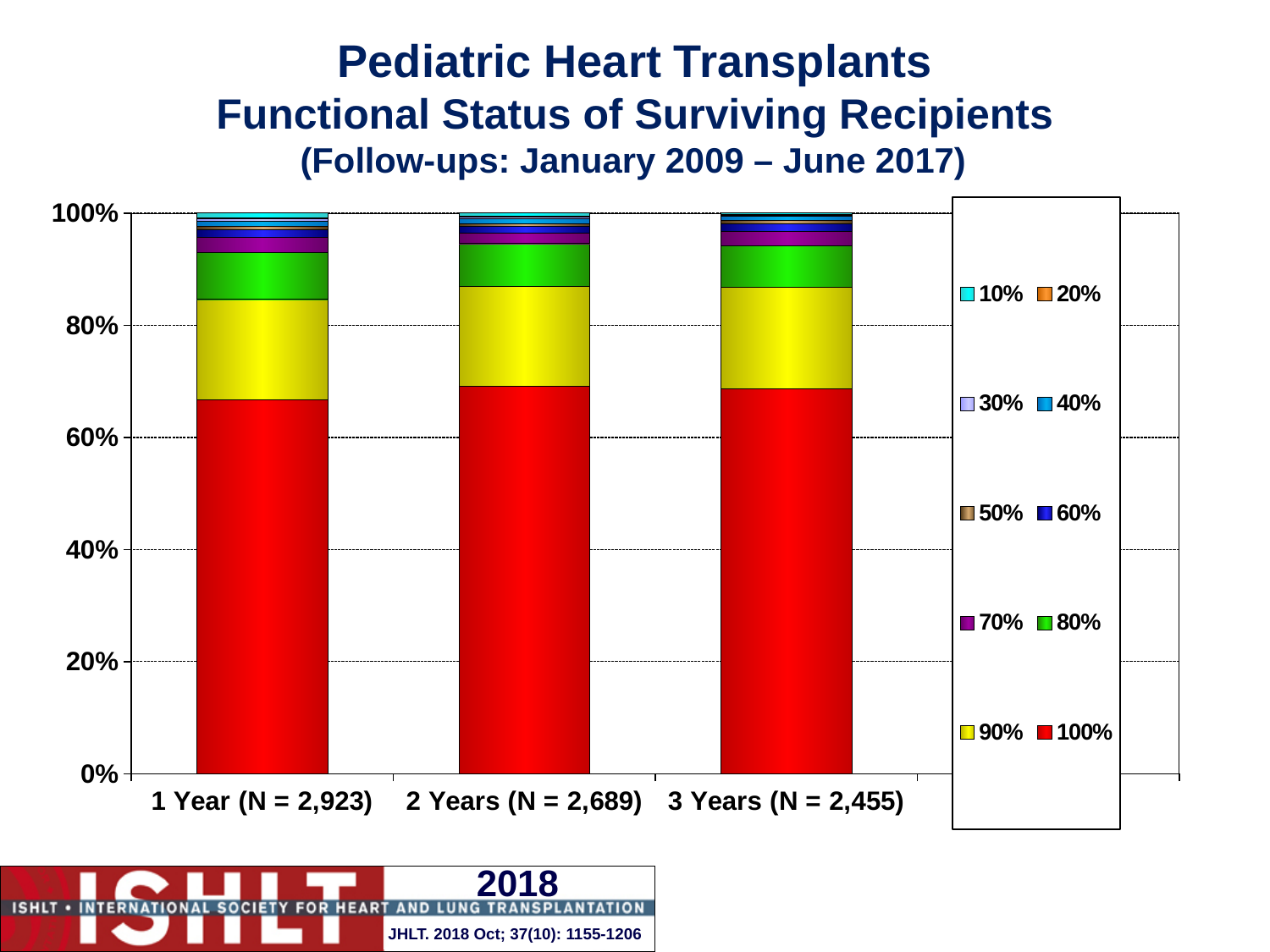
What follow-up period is stated in the chart title? January 2009 – June 2017 Does the top of the 90% segment for 2 Years (N = 2,689) lie above or below the 80% gridline? above Which series occupies the largest portion of each stacked bar? 100% Is the 100% functional status segment for 2 Years (N = 2,689) greater or less than 80%? less Is the 100% functional status segment for 3 Years (N = 2,455) greater or less than 60%? greater What kind of chart is shown on the slide? Stacked bar chart How many categories are shown on the x axis? 3 How many series does the legend list? 10 What is the N value shown in the x-axis label for 3 Years? 2,455 What is the total height of the stacked bar for 1 Year (N = 2,923)? 100%